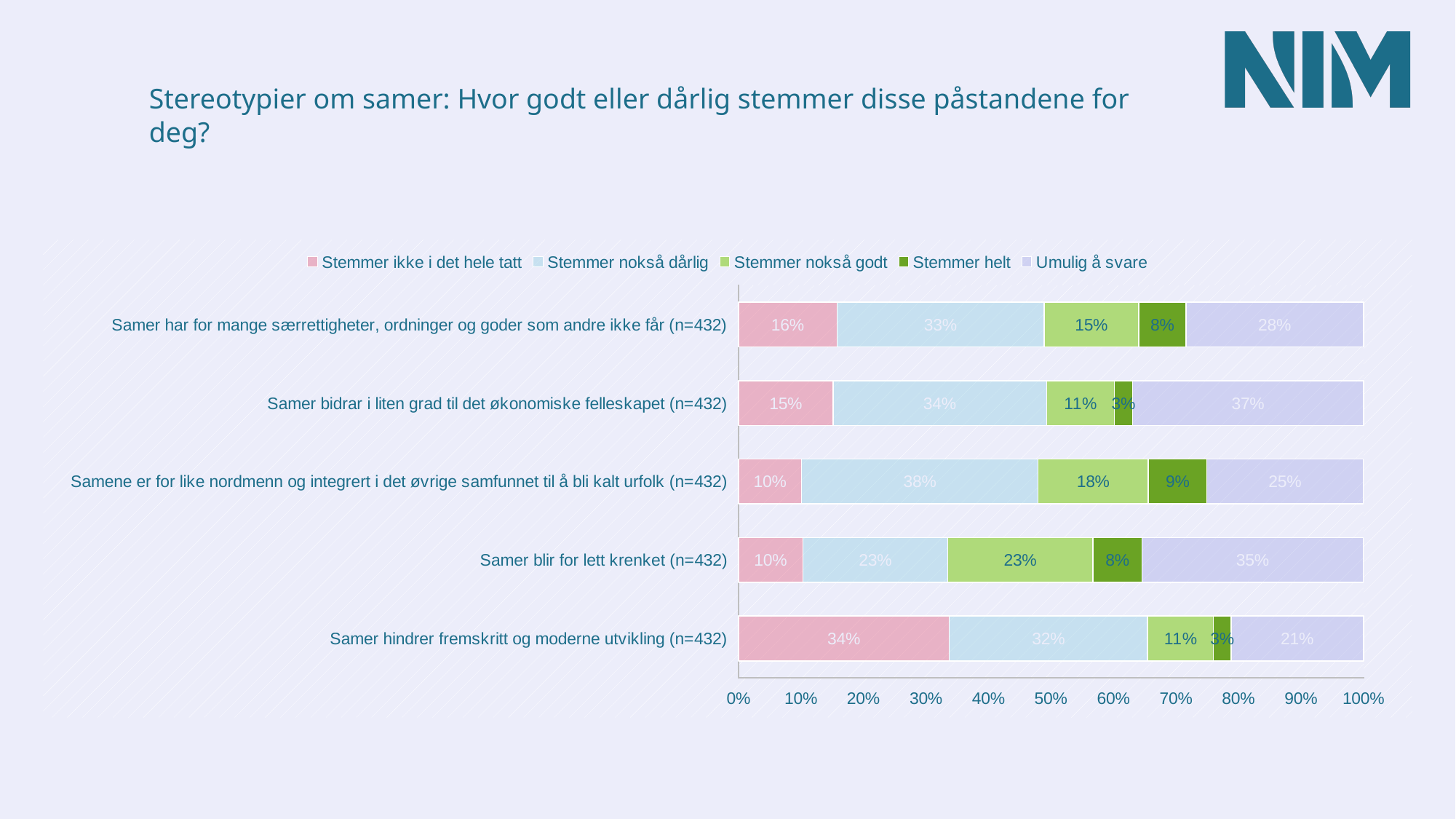
Which statement has the lowest value for 'Umulig å svare'? Samer hindrer fremskritt og moderne utvikling (n=432) Which legend entry is shown in dark green? Stemmer helt What is the value of 'Stemmer ikke i det hele tatt' for 'Samer hindrer fremskritt og moderne utvikling (n=432)'? 34% What kind of chart is shown on the slide? Stacked bar chart What is the value of 'Stemmer helt' for 'Samene er for like nordmenn og integrert i det øvrige samfunnet til å bli kalt urfolk (n=432)'? 9% What is the difference between the 'Stemmer nokså dårlig' values for 'Samene er for like nordmenn og integrert i det øvrige samfunnet til å bli kalt urfolk (n=432)' and 'Samer blir for lett krenket (n=432)'? 15% Which is larger: 'Stemmer helt' for 'Samer har for mange særrettigheter, ordninger og goder som andre ikke får (n=432)' or 'Stemmer helt' for 'Samer bidrar i liten grad til det økonomiske felleskapet (n=432)'? Samer har for mange særrettigheter, ordninger og goder som andre ikke får (n=432) How many statements (categories) are plotted in the chart? 5 Which statement has the highest value for 'Stemmer ikke i det hele tatt'? Samer hindrer fremskritt og moderne utvikling (n=432) What is the value of 'Stemmer nokså godt' for 'Samer blir for lett krenket (n=432)'? 23% What is the value of 'Umulig å svare' for 'Samer bidrar i liten grad til det økonomiske felleskapet (n=432)'? 37% How many series does the legend list? 5